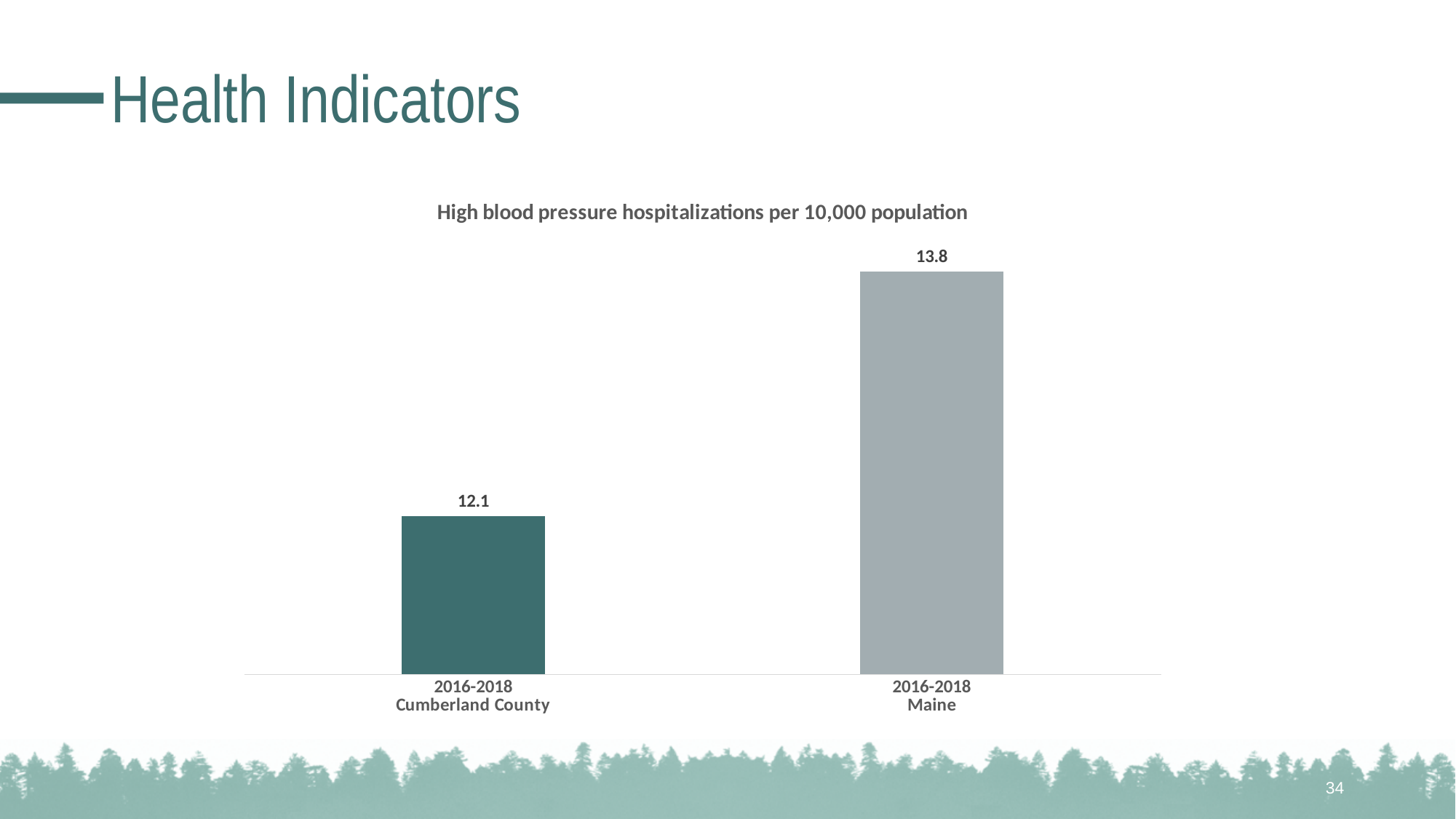
How many categories are shown in the chart? 2 What time period do both bars in the chart cover? 2016-2018 What is the title of the chart? High blood pressure hospitalizations per 10,000 population What is the value for 2016-2018 Cumberland County? 12.1 Which is larger, the value for Cumberland County or the value for Maine? Maine What kind of chart is shown on the slide? Bar chart Which category has the highest value? 2016-2018 Maine Which category has the lowest value? 2016-2018 Cumberland County What is the difference between the values for Maine and Cumberland County? 1.7 What is the value for 2016-2018 Maine? 13.8